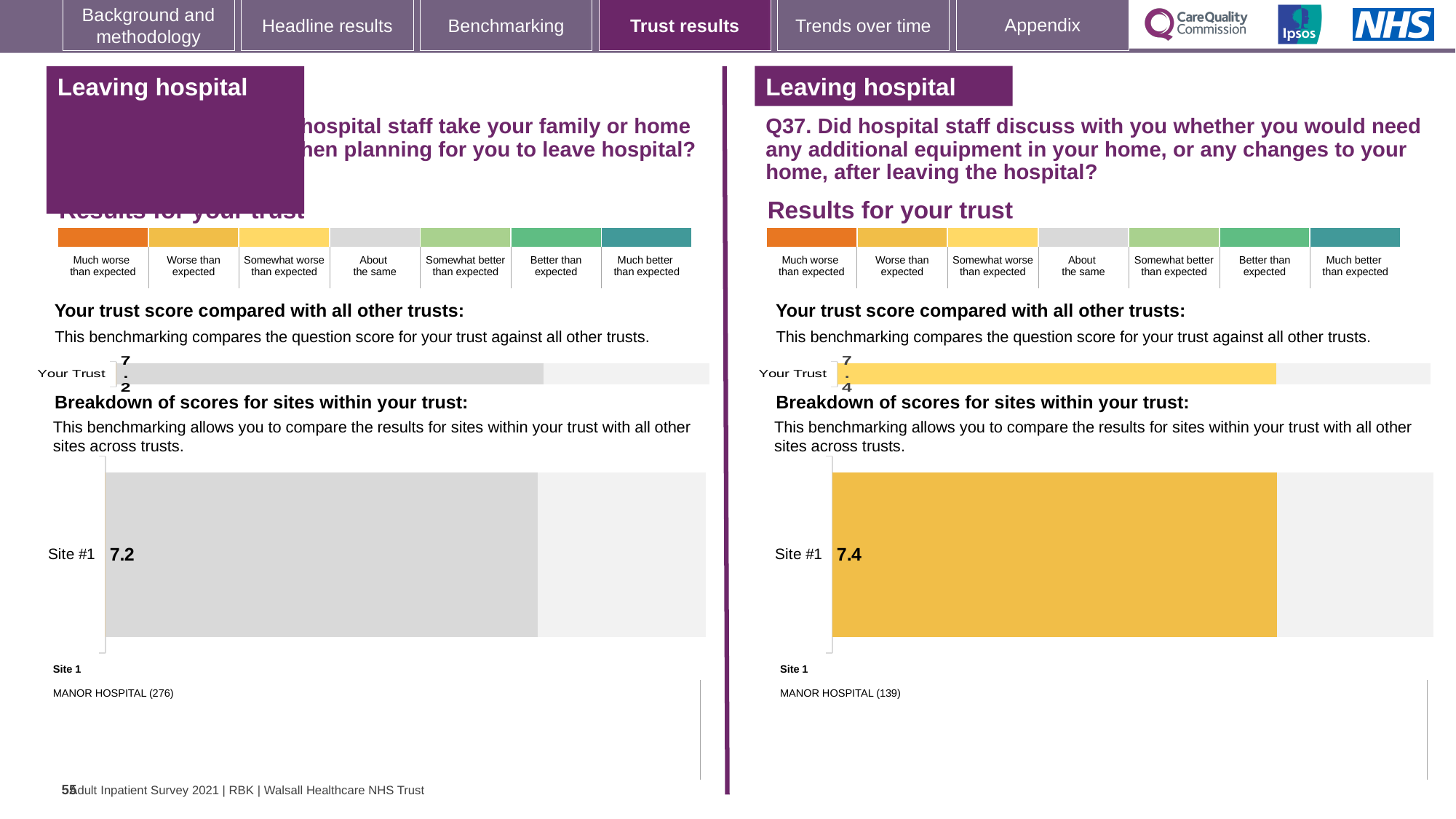
On the left-hand chart, what is the score shown for Your Trust? 7.2 How many sites are shown in the site breakdown chart on the left-hand side? 1 What type of chart is used to show the Site #1 score on the right-hand chart for Q37? Bar chart On the left-hand chart, what colour is the Site #1 bar? Grey On the left-hand chart, what is the score shown for Site #1? 7.2 On the right-hand chart for Q37, what is the score shown for Site #1? 7.4 On the right-hand chart for Q37, what colour is the Site #1 bar? Yellow On the right-hand chart for Q37, what is the score shown for Your Trust? 7.4 Which site name is listed as Site 1 under the right-hand chart for Q37? MANOR HOSPITAL (139) What is the difference between the Site #1 score on the right-hand chart for Q37 and the Site #1 score on the left-hand chart? 0.2 Which is larger: the Site #1 score on the left-hand chart or the Site #1 score on the right-hand chart for Q37? Right-hand chart (Q37) How many sites are shown in the site breakdown chart on the right-hand side for Q37? 1